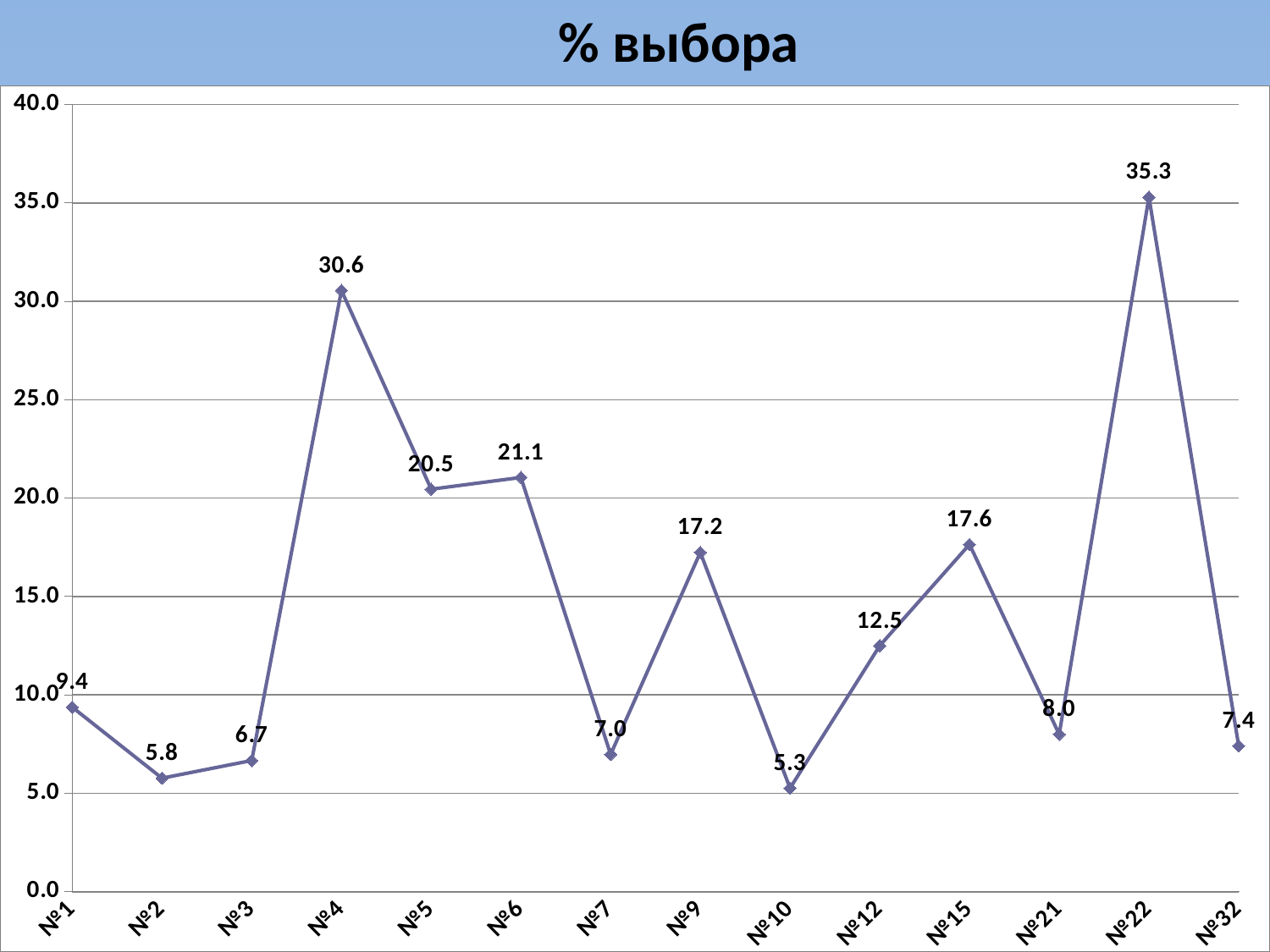
Is the value for №9 greater or less than 15.0? greater Which category has the highest value? №22 What is the title of the chart? % выбора What is the value for №4? 30.6 What kind of chart is this? line chart Which is larger, the value for №5 or the value for №6? №6 Which category has the lowest value? №10 What is the value for №22? 35.3 What is the value for №10? 5.3 What is the value for №15? 17.6 How many categories are shown on the x axis? 14 What is the difference between the values for №22 and №4? 4.7